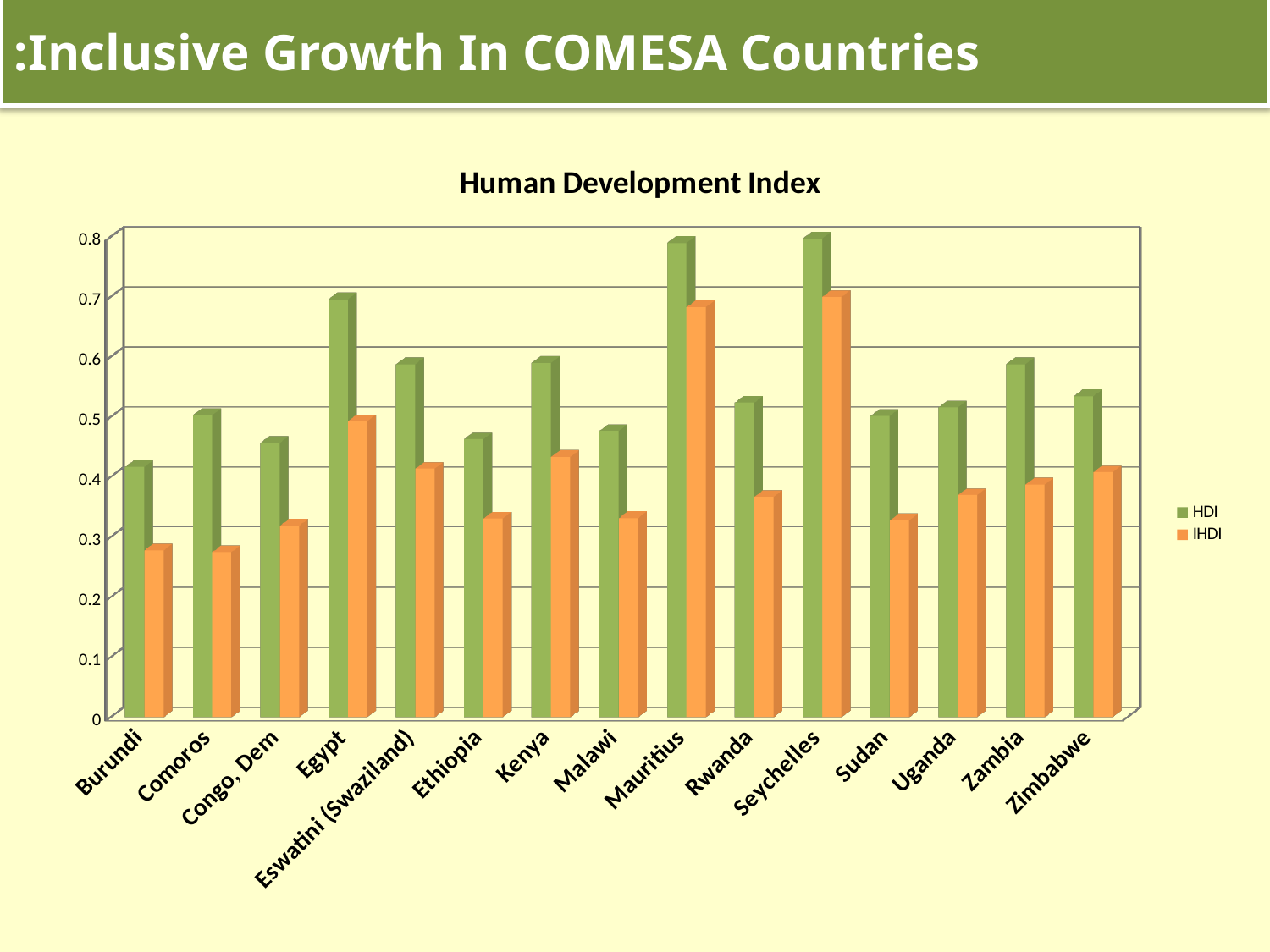
Which is larger, the HDI value for Egypt or the HDI value for Kenya? Egypt Which colour represents the IHDI series in the chart? Orange Is the HDI value for Kenya greater or less than 0.5? greater Which is larger, the IHDI value for Mauritius or the IHDI value for Egypt? Mauritius How many countries are shown on the x axis of the chart? 15 What is the title of the chart? Human Development Index Which country has the lowest HDI value? Burundi Is the HDI value for Malawi greater or less than 0.5? less What kind of chart is shown on the slide? Bar chart Is the IHDI value for Rwanda greater or less than 0.4? less How many series does the legend list? 2